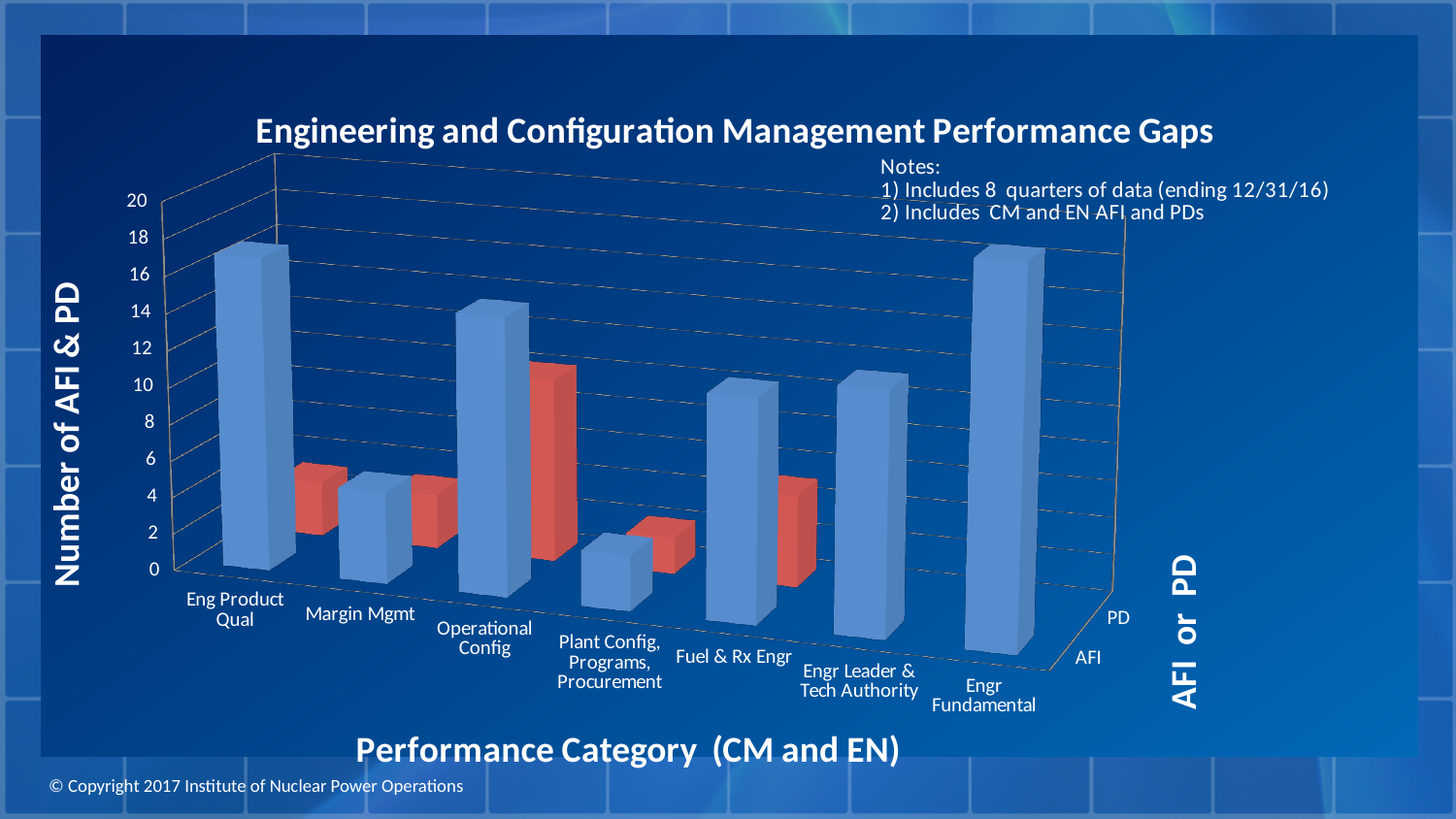
What is the title of the chart? Engineering and Configuration Management Performance Gaps Is the AFI value for Eng Product Qual greater or less than 10? greater What type of chart is shown on the slide? bar chart Which category has the highest PD value? Operational Config Which is larger, the AFI value for Operational Config or the AFI value for Margin Mgmt? Operational Config Is the AFI value for Plant Config, Programs, Procurement greater or less than 6? less Which category has the lowest AFI value? Plant Config, Programs, Procurement Is the PD value for Operational Config greater or less than 6? greater How many performance categories are shown on the x axis of the chart? 7 What is the label of the vertical axis? Number of AFI & PD Which is larger, the PD value for Operational Config or the PD value for Fuel & Rx Engr? Operational Config